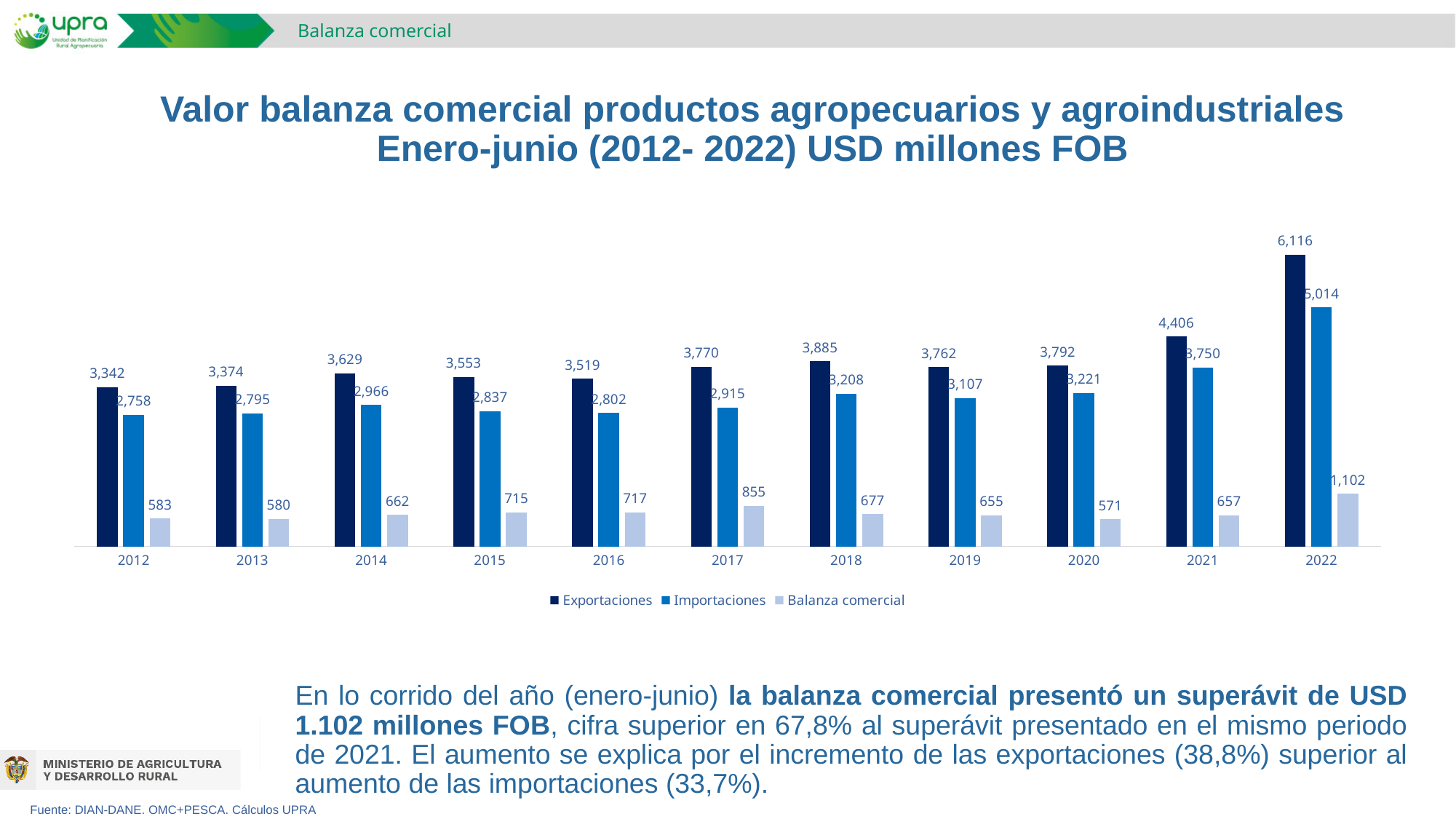
Which is larger, Balanza comercial in 2017 or in 2018? 2017 In which year is Exportaciones highest? 2022 What is the value of Balanza comercial for 2017? 855 By how much did Balanza comercial increase from 2021 to 2022? 445 Do the Exportaciones values rise or fall from 2019 to 2022? Rise What is the difference between Exportaciones and Importaciones in 2022? 1,102 What is the value of Importaciones for 2015? 2,837 What is the value of Exportaciones for 2018? 3,885 In which year is Balanza comercial lowest? 2020 How many series does the legend list? 3 How many years are shown on the x axis? 11 What kind of chart is shown on the slide? Bar chart